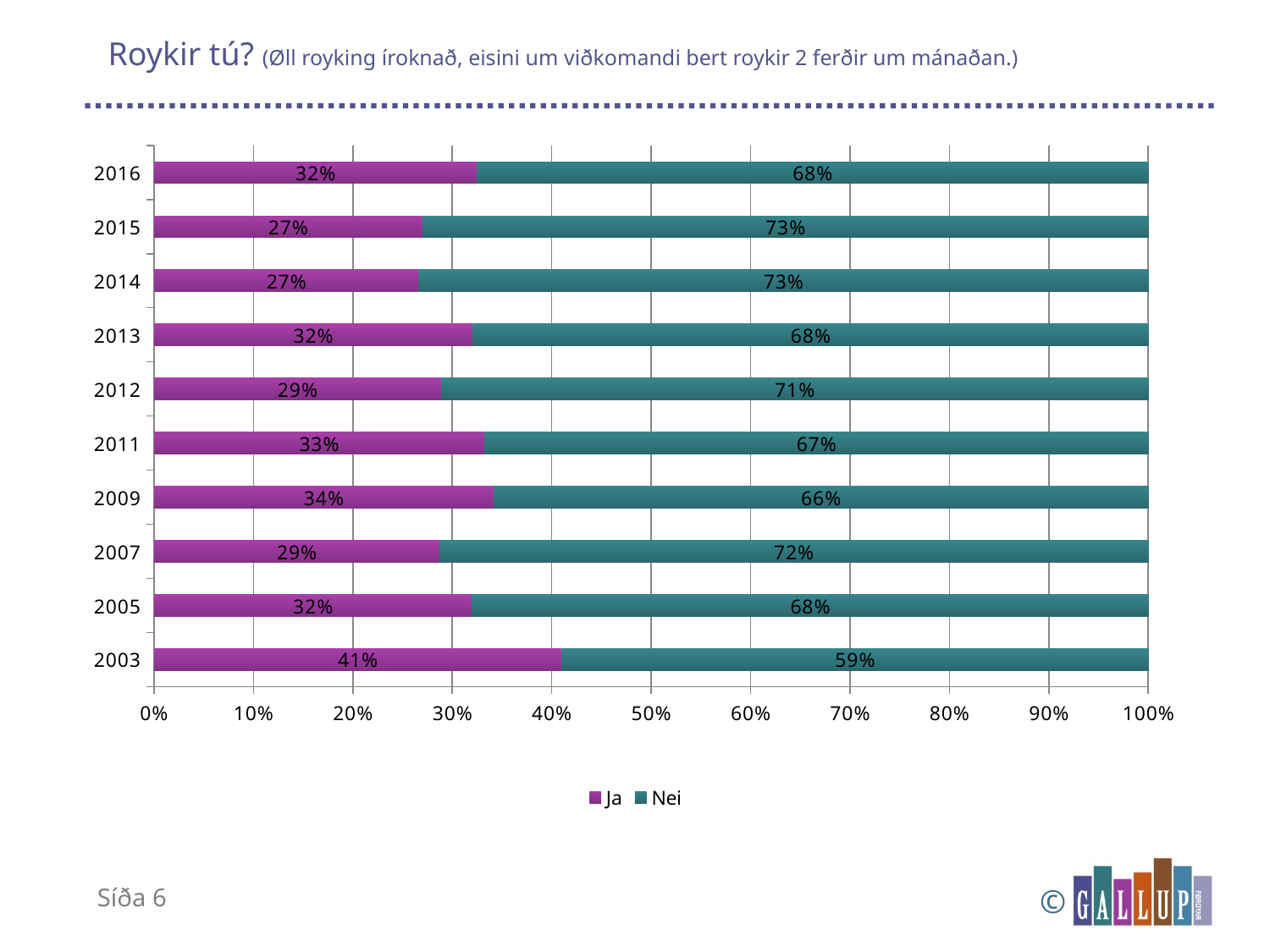
How many years are shown on the chart? 10 What is the value for Nei in 2003? 59% In which year is the Nei share lowest? 2003 How many series does the legend list? 2 In which year is the Ja share highest? 2003 Which is larger, the Ja value in 2009 or the Ja value in 2015? 2009 What is the difference between the Ja value in 2003 and the Ja value in 2016? 9 percentage points What is the value for Nei in 2012? 71% Is the value for Ja in 2003 greater or less than 40%? greater What kind of chart is shown on the slide? Stacked bar chart What is the value for Ja in 2016? 32% What are the two legend entries of the chart? Ja and Nei